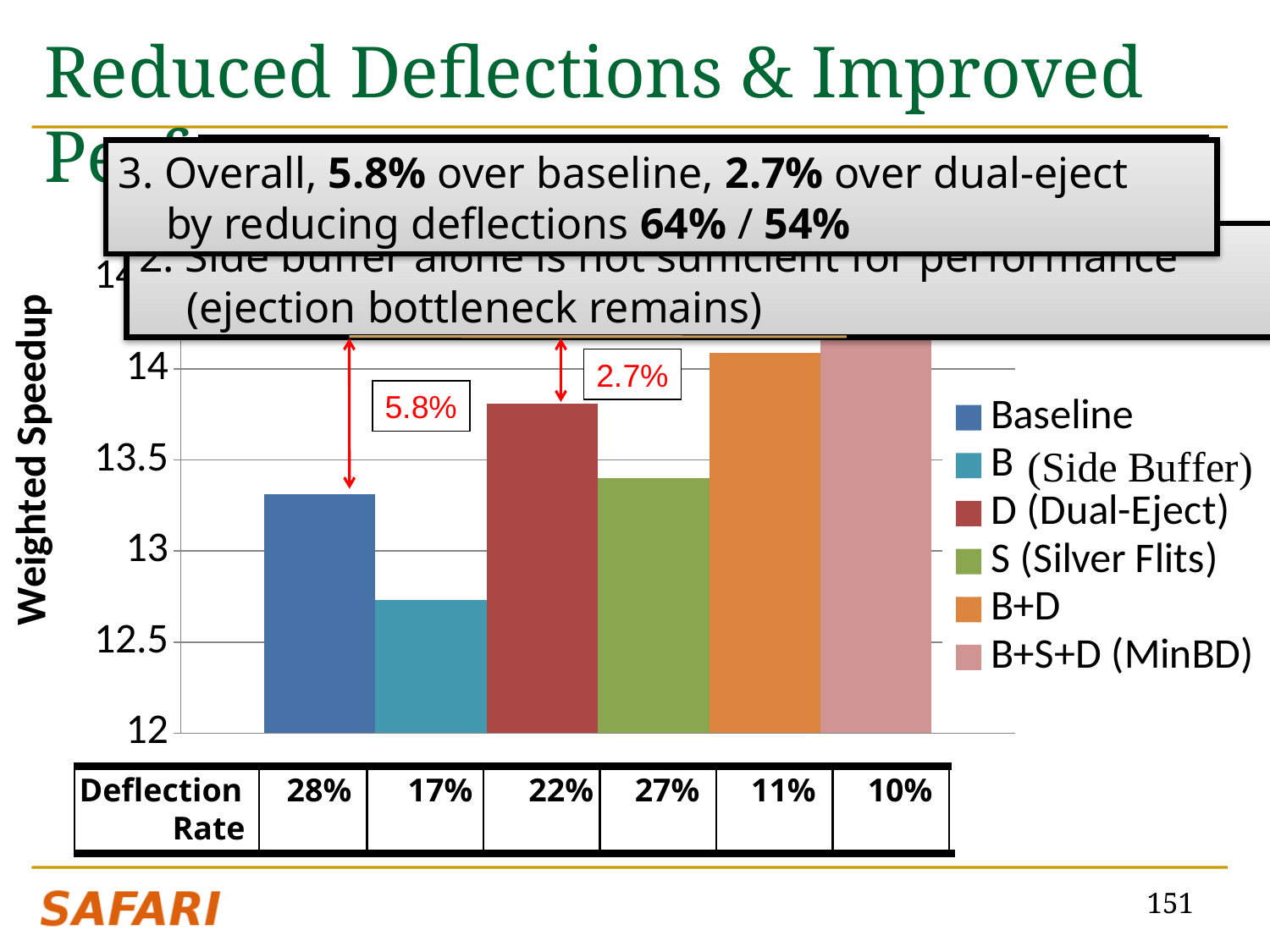
How many bars are plotted in the chart? 6 What kind of chart is shown on the slide? bar chart Which configuration has the highest weighted speedup? B+S+D (MinBD) What is the label of the vertical axis? Weighted Speedup How many entries does the chart legend list? 6 Which has a higher weighted speedup, Baseline or D (Dual-Eject)? D (Dual-Eject) Is the weighted speedup for B+D greater or less than 14? greater Is the weighted speedup for D (Dual-Eject) greater or less than 13.5? greater Is the weighted speedup for B (Side Buffer) greater or less than 13? less What percentage improvement is annotated between the Baseline bar and the B+S+D (MinBD) bar? 5.8% Which configuration has the lowest weighted speedup? B (Side Buffer)